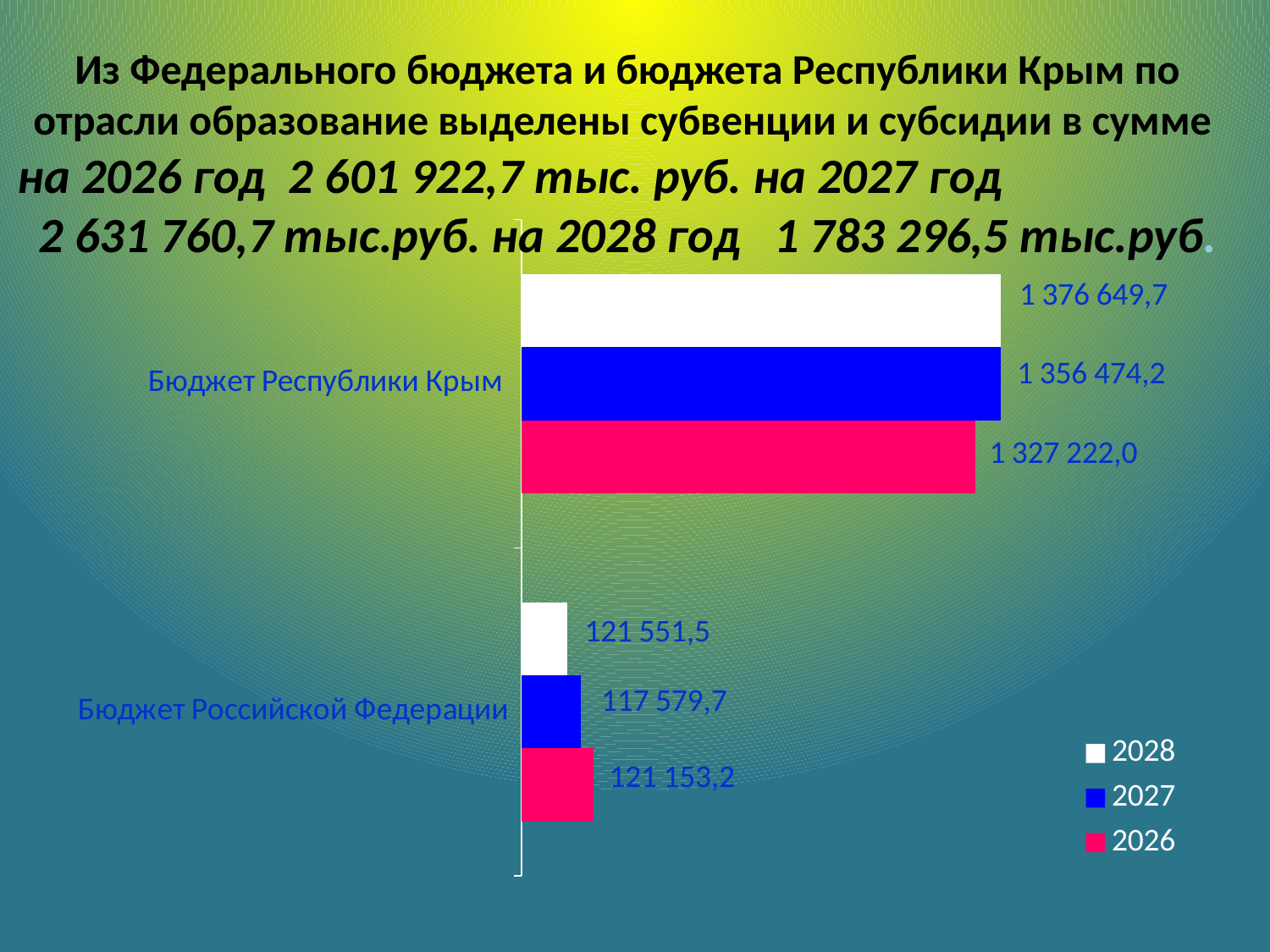
What is the value for Бюджет Российской Федерации in 2027? 117 579,7 What is the value for Бюджет Республики Крым in 2026? 1 327 222,0 What is the difference between the 2028 and 2027 values for Бюджет Республики Крым? 20 175,5 What is the value for Бюджет Республики Крым in 2027? 1 356 474,2 What is the value for Бюджет Российской Федерации in 2026? 121 153,2 What is the value for Бюджет Российской Федерации in 2028? 121 551,5 What is the value for Бюджет Республики Крым in 2028? 1 376 649,7 How many series does the legend list? 3 Which year has the highest value for Бюджет Республики Крым? 2028 Which year has the lowest value for Бюджет Российской Федерации? 2027 Which is larger for Бюджет Российской Федерации: the 2026 value or the 2028 value? 2028 What kind of chart is shown on the slide? bar chart